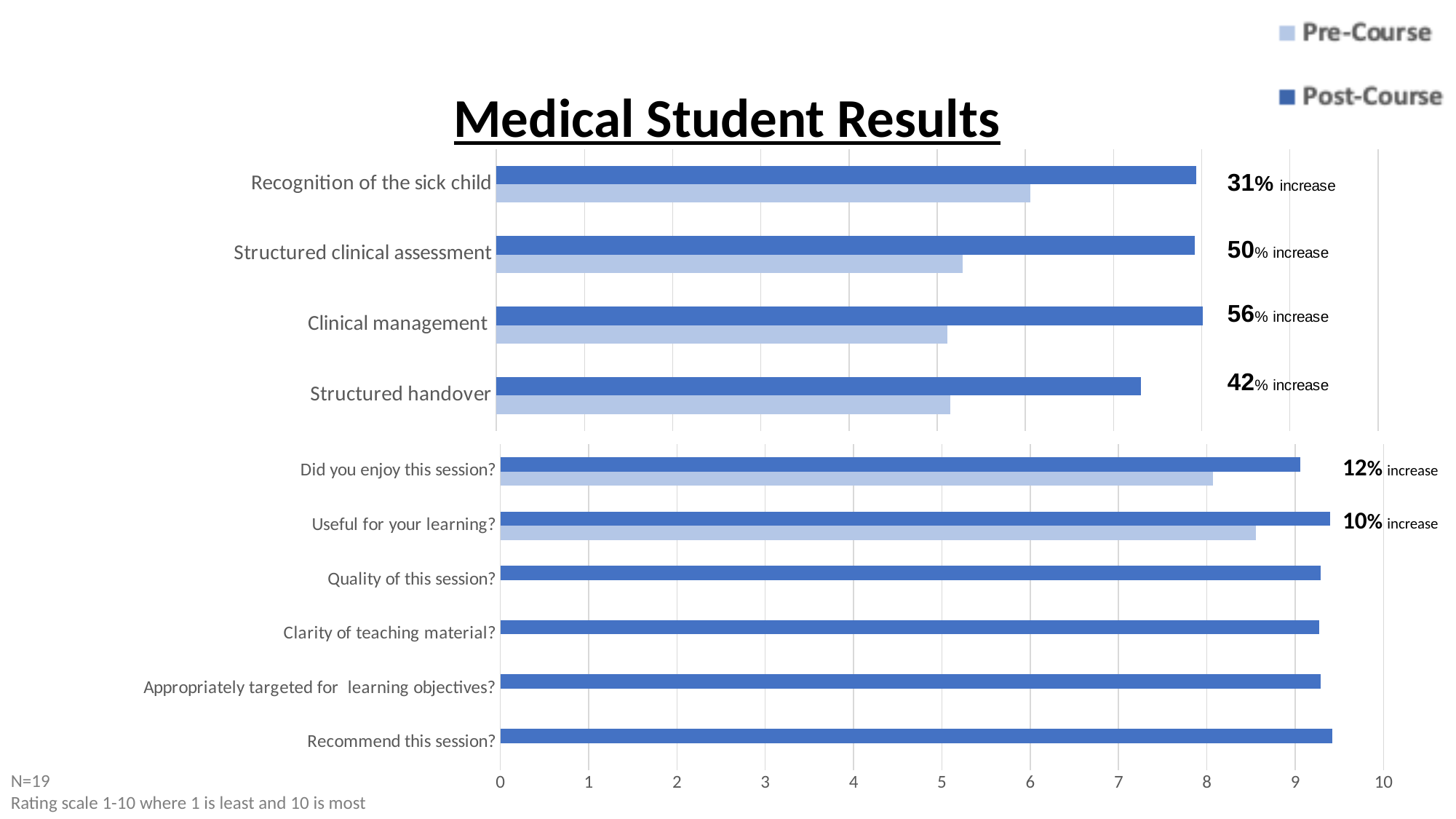
What kind of chart is the top chart on the slide? bar chart In the bottom chart, is the Pre-Course value for 'Useful for your learning?' greater or less than 8? greater In the top chart, is the Post-Course value for Structured handover greater or less than 8? less In the top chart, which category shows the largest percentage increase? Clinical management How many categories are plotted in the top chart? 4 In the top chart, what percentage increase is shown for Clinical management? 56% increase How many series does the legend list? 2 In the top chart, is the Pre-Course value for Recognition of the sick child greater or less than 7? less In the top chart, which is larger: the Pre-Course value for Recognition of the sick child or the Pre-Course value for Structured clinical assessment? Recognition of the sick child In the bottom chart, what percentage increase is shown for 'Did you enjoy this session?' 12% increase In the top chart, which category has the lowest Post-Course value? Structured handover How many categories are plotted in the bottom chart? 6